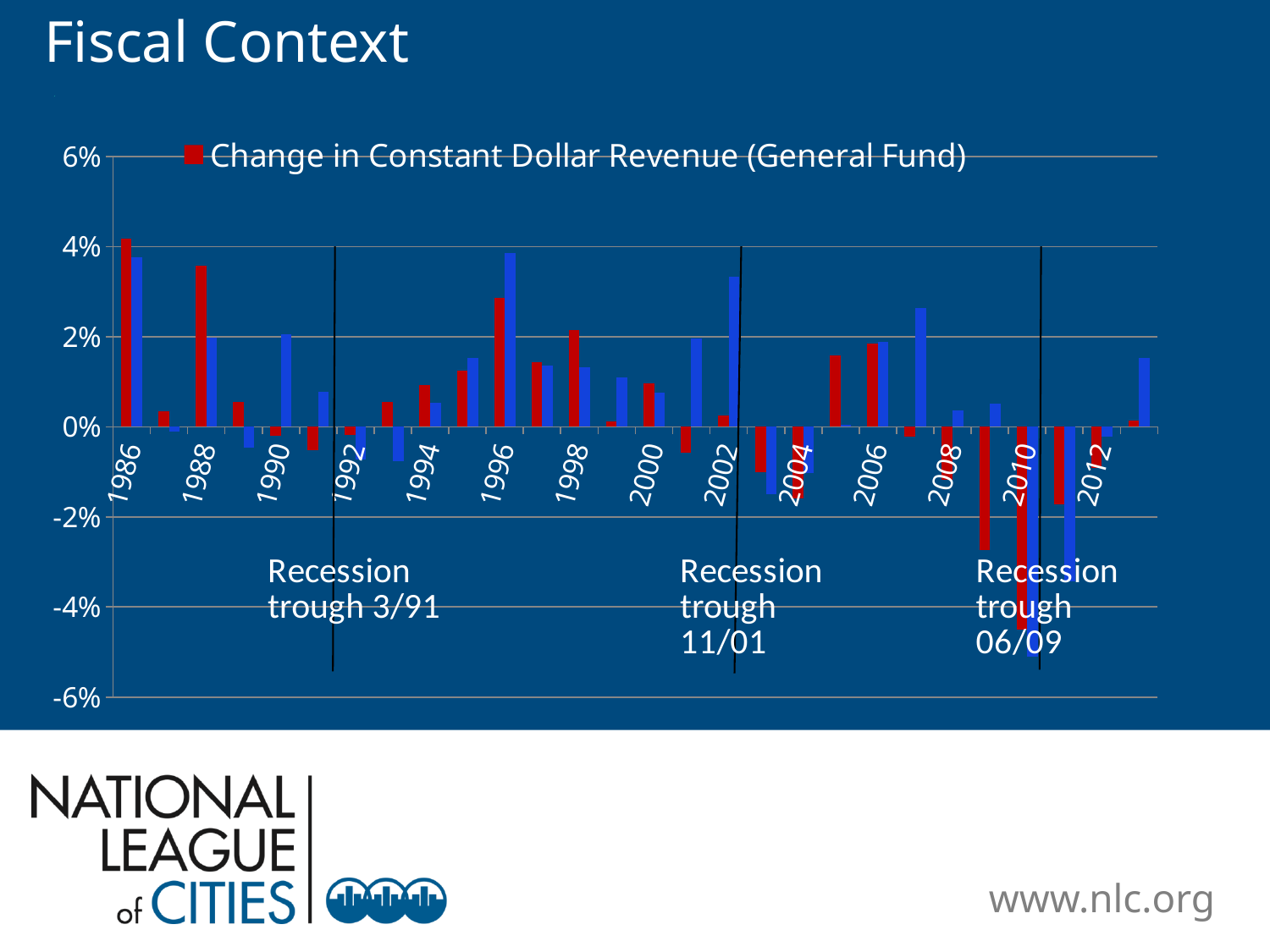
Which year has the highest red bar (Change in Constant Dollar Revenue)? 1986 Which year has the lowest blue bar? 2010 Is the red bar for 2010 greater or less than -4%? less Is the blue bar for 1996 greater or less than 2%? greater Is the red bar for 1988 greater or less than 2%? greater Which is larger, the red bar for 1988 or the red bar for 1996? 1988 What is the title of the chart's legend entry shown in red? Change in Constant Dollar Revenue (General Fund) Between 2007 and 2010, do the red bars rise or fall? fall What date is given for the third recession trough marked on the chart? 06/09 Which year has the lowest red bar (Change in Constant Dollar Revenue)? 2010 What kind of chart is shown on the slide? bar chart